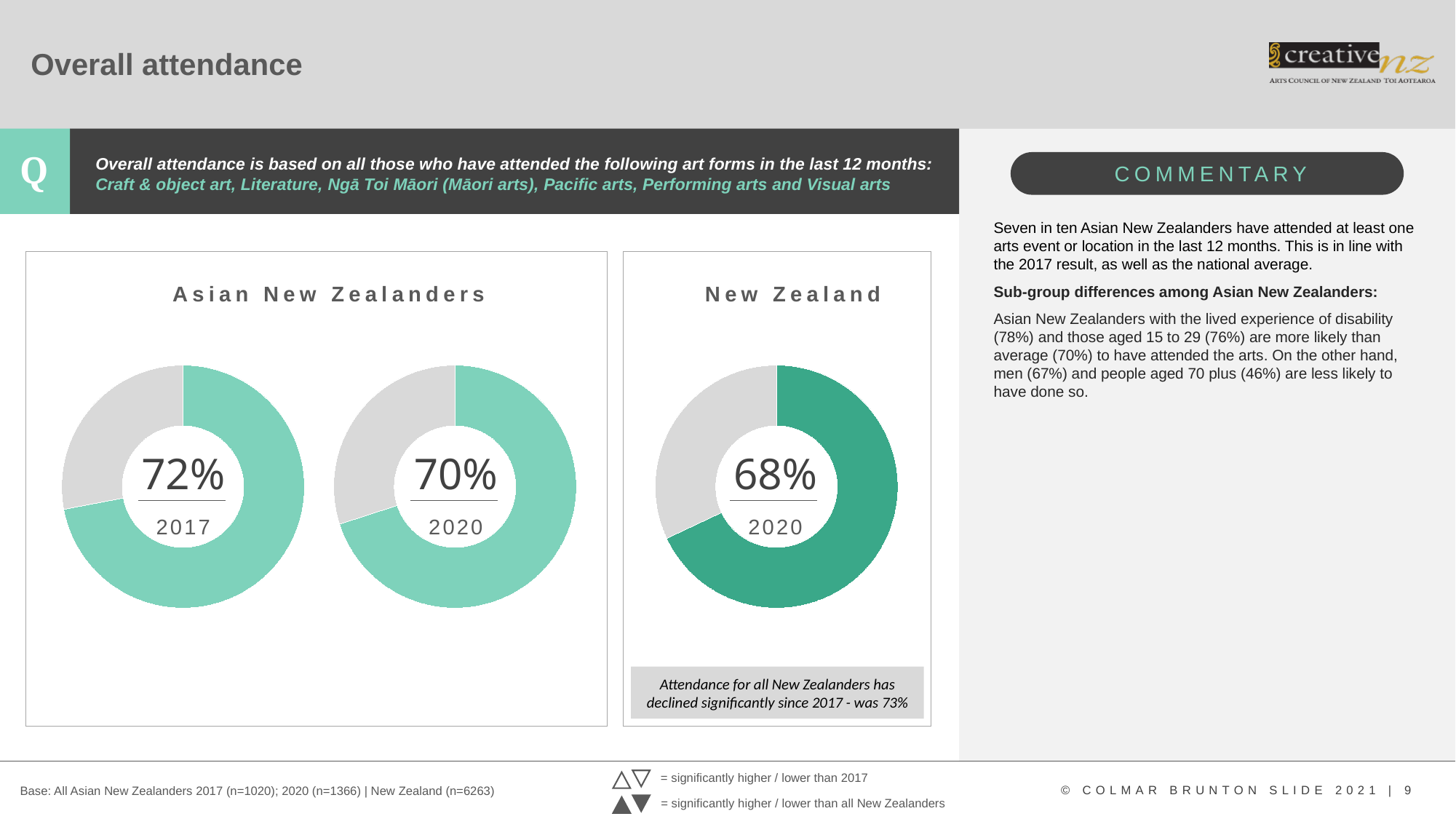
In the Asian New Zealanders chart, which year has the higher attendance value, 2017 or 2020? 2017 In the Asian New Zealanders chart, does the attendance value rise or fall from 2017 to 2020? fall In the New Zealand chart, what is the attendance value shown for 2020? 68% What is the title of the chart panel on the left of the slide? Asian New Zealanders How many donut charts are shown in the Asian New Zealanders panel? 2 What is the difference between the 2020 value for Asian New Zealanders and the 2020 value for New Zealand? 2 percentage points Comparing the 2020 values, which is larger: Asian New Zealanders or New Zealand? Asian New Zealanders What kind of chart is used to show the attendance values on this slide? Donut (pie) chart Across all charts on the slide, which chart shows the lowest attendance value? New Zealand 2020 (68%) In the Asian New Zealanders chart, by how many percentage points did attendance change from 2017 to 2020? 2 percentage points In the Asian New Zealanders chart, what is the attendance value shown for 2017? 72% In the Asian New Zealanders chart, what is the attendance value shown for 2020? 70%